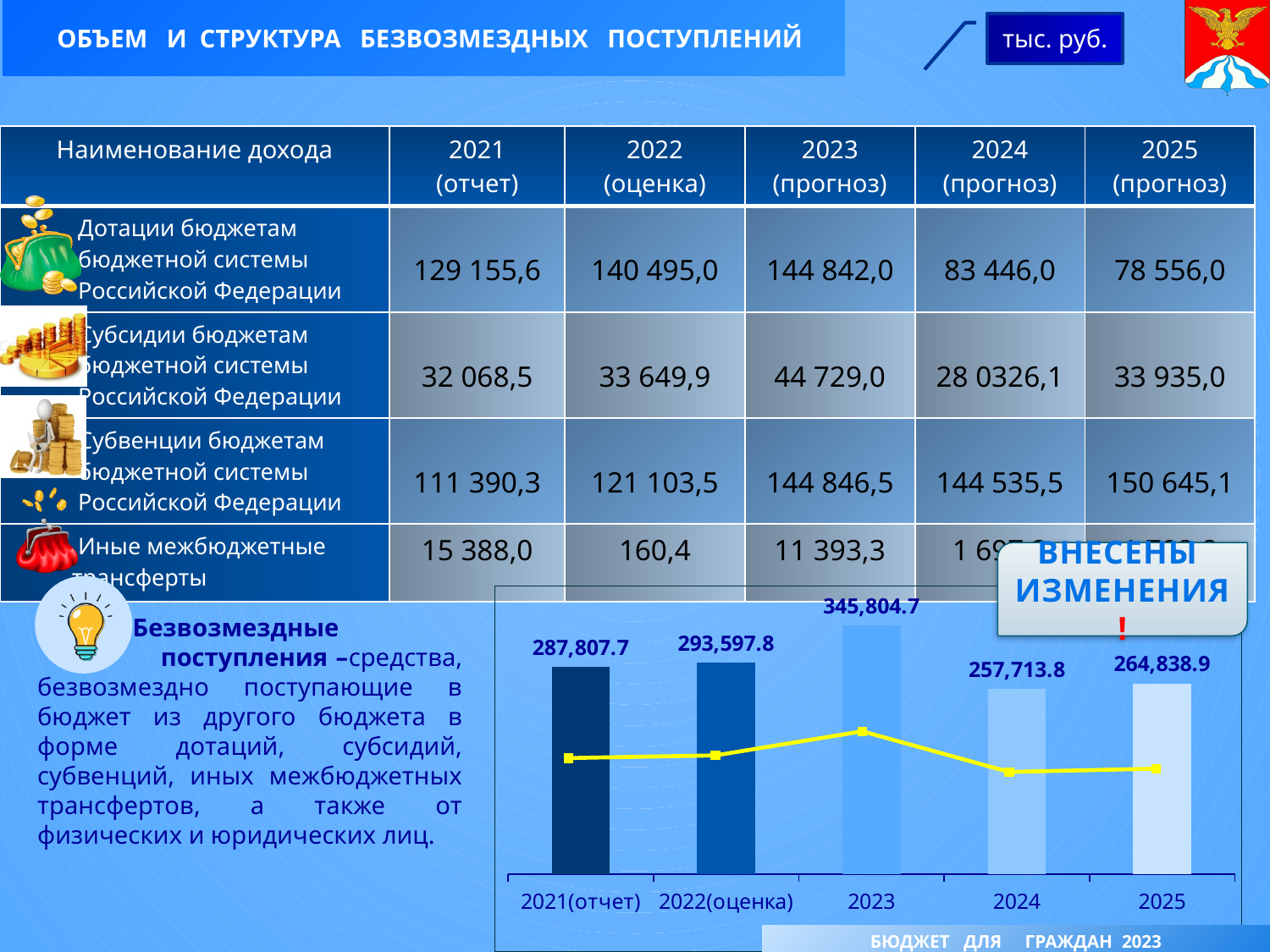
How many years (categories) are shown on the x axis of the bar chart at the bottom of the slide? 5 In the bar chart at the bottom of the slide, which year has the lowest value? 2024 In the bar chart at the bottom of the slide, do the values rise or fall from 2023 to 2024? fall In the bar chart at the bottom of the slide, what is the value for 2025? 264,838.9 In the bar chart at the bottom of the slide, what is the value for 2024? 257,713.8 What kind of chart is used at the bottom of the slide to show the yearly values? bar chart In the bar chart at the bottom of the slide, what is the value for 2021(отчет)? 287,807.7 In the bar chart at the bottom of the slide, what is the difference between the 2025 value and the 2024 value? 7,125.1 In the bar chart at the bottom of the slide, which year has the highest value? 2023 In the bar chart at the bottom of the slide, which is larger: the value for 2022(оценка) or the value for 2025? 2022(оценка) In the bar chart at the bottom of the slide, what is the value for 2023? 345,804.7 In the bar chart at the bottom of the slide, what is the difference between the 2023 value and the 2022(оценка) value? 52,206.9